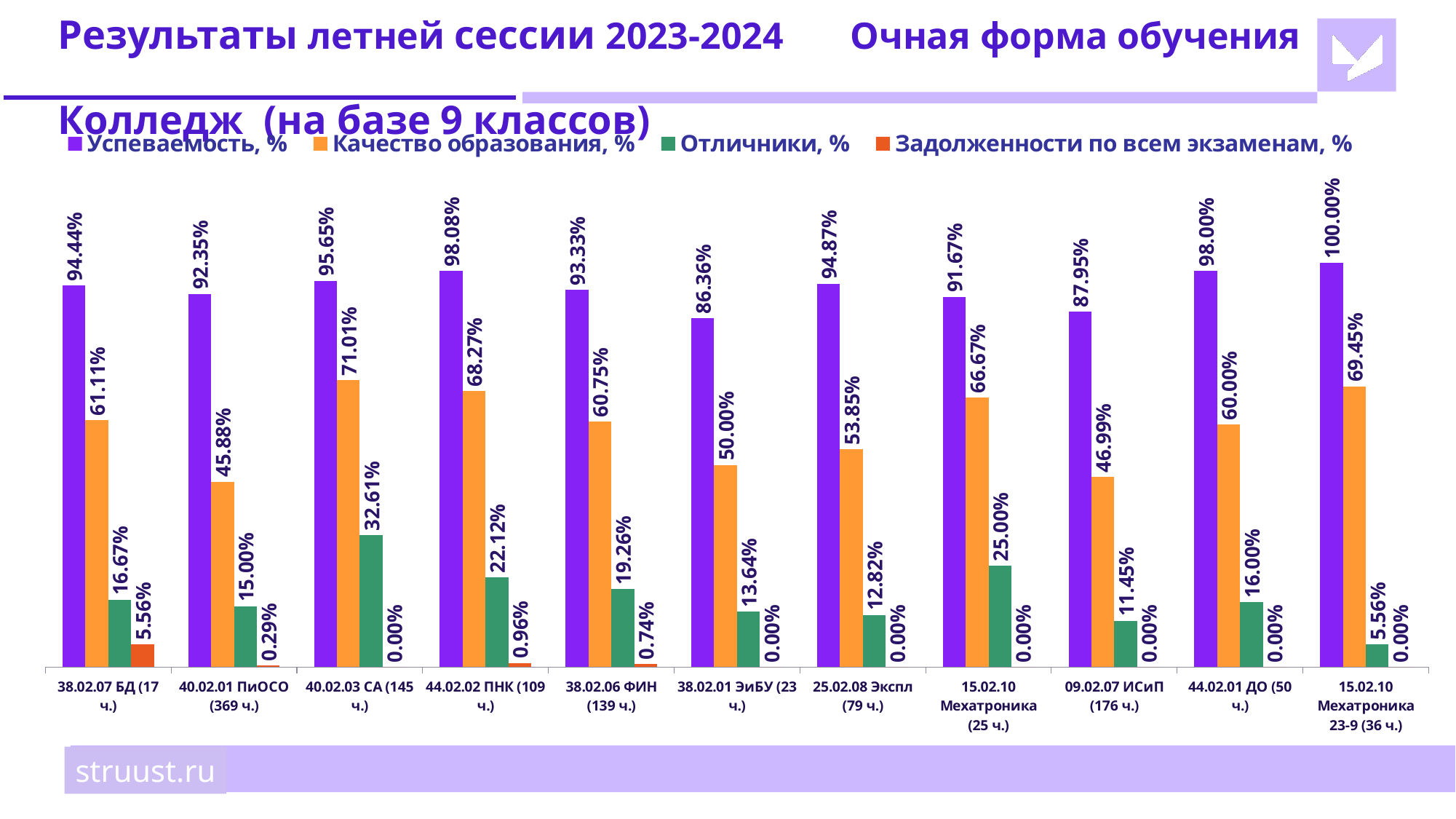
What is the difference between Качество образования, % for 40.02.03 СА (145 ч.) and 40.02.01 ПиОСО (369 ч.)? 25.13% How many series does the legend list? 4 Which is larger: Отличники, % for 44.02.02 ПНК (109 ч.) or for 38.02.06 ФИН (139 ч.)? 44.02.02 ПНК (109 ч.) What is the value of Успеваемость, % for 44.02.02 ПНК (109 ч.)? 98.08% What is the value of Качество образования, % for 15.02.10 Мехатроника (25 ч.)? 66.67% What is the value of Отличники, % for 40.02.03 СА (145 ч.)? 32.61% How many categories are shown on the x axis of the chart? 11 Which category has the highest Успеваемость, %? 15.02.10 Мехатроника 23-9 (36 ч.) What is the value of Задолженности по всем экзаменам, % for 38.02.07 БД (17 ч.)? 5.56% Which category has the highest Качество образования, %? 40.02.03 СА (145 ч.) Which category has the lowest Успеваемость, %? 38.02.01 ЭиБУ (23 ч.) What kind of chart is shown on the slide? Bar chart